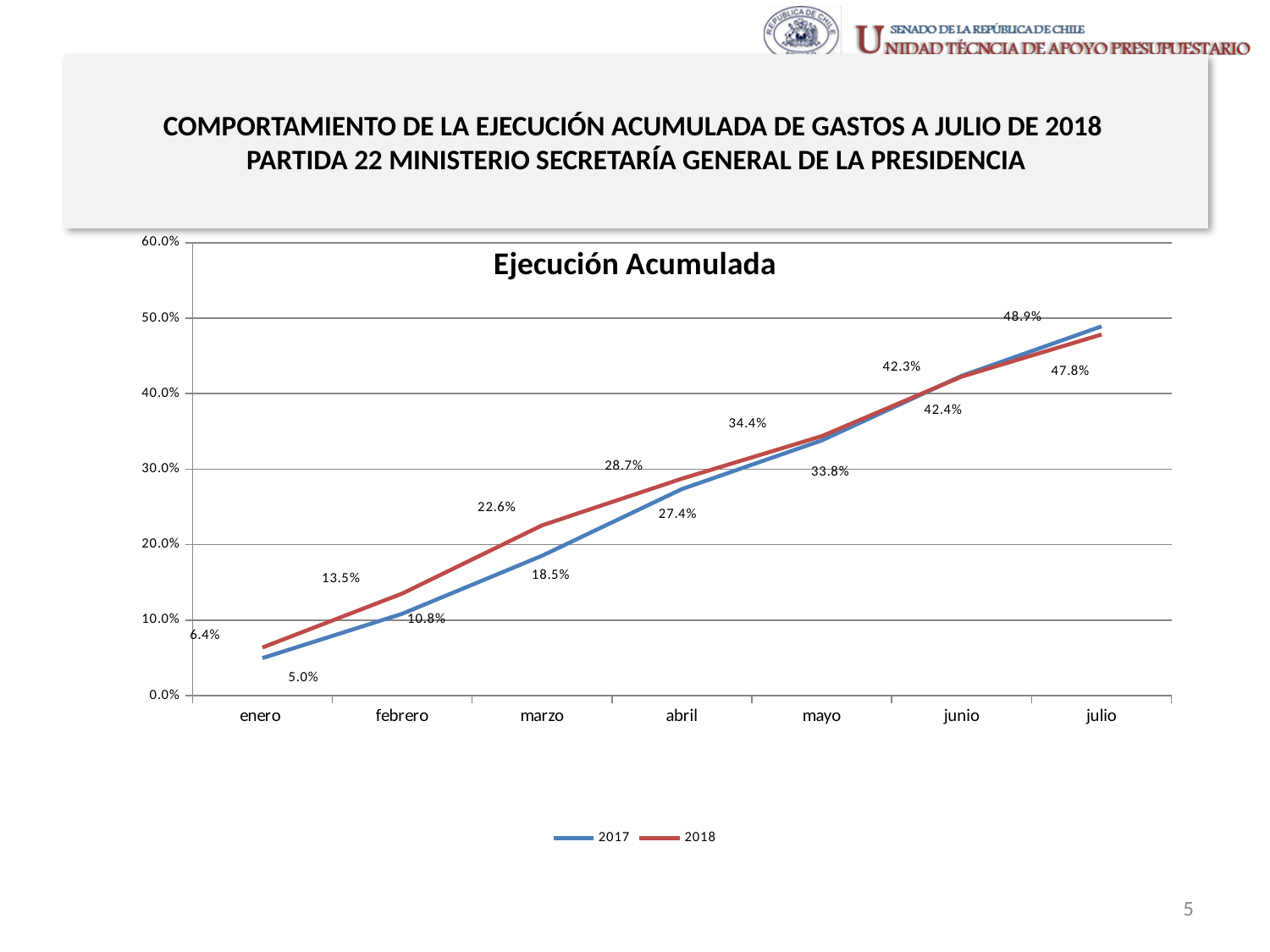
Do the values of the 2018 series rise or fall from enero to julio? rise What is the value for 2018 in marzo? 22.6% How many months are shown on the x axis? 7 What is the value for 2017 in enero? 5.0% What is the value for 2018 in mayo? 34.4% What is the value for 2017 in abril? 27.4% In febrero, which series has the higher value, 2017 or 2018? 2018 In which month is the 2017 series at its lowest? enero What is the difference between the 2018 and 2017 values in marzo? 4.1 percentage points What kind of chart is shown? line chart What is the value for 2018 in enero? 6.4% How many series does the legend list? 2